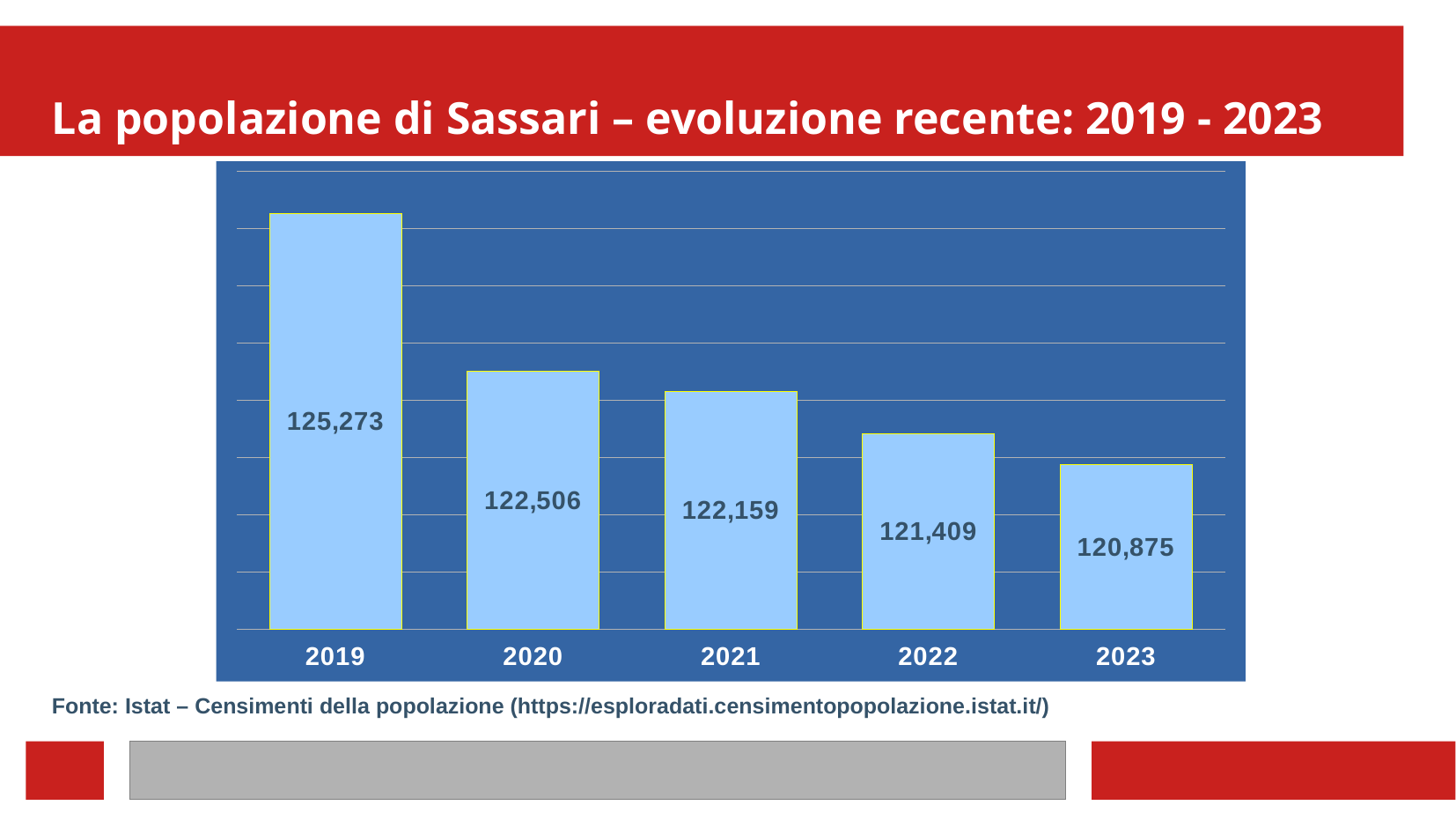
Which year has the lowest population value? 2023 Which year has the highest population value? 2019 What is the difference between the population in 2022 and in 2023? 534 What is the population value shown for 2021? 122,159 Do the population values rise or fall from 2019 to 2023? Fall What is the population of Sassari shown for 2019? 125,273 By how much did the population decrease from 2019 to 2023? 4,398 What is the difference between the population in 2019 and in 2020? 2,767 What is the population value shown for 2023? 120,875 What kind of chart is shown on the slide? Bar chart Which is larger, the population in 2020 or in 2021? 2020 How many years are shown on the chart? 5